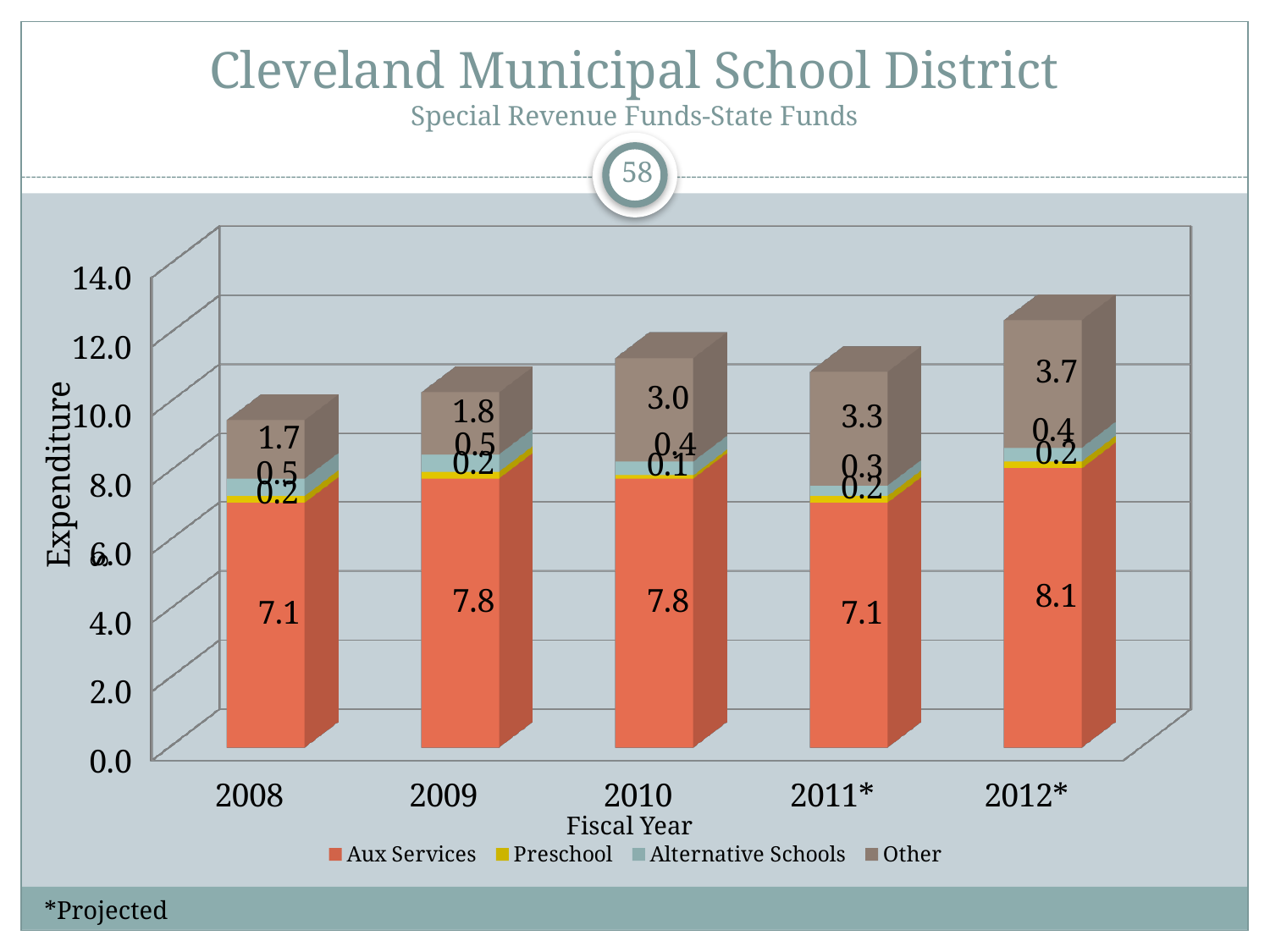
What is the Other value for fiscal year 2010? 3.0 How many series does the legend list? 4 What is the Aux Services value for 2012*? 8.1 What is the total of the stacked bar for 2012*? 12.4 Which fiscal year has the highest Other value? 2012* Does the Other value rise or fall from 2008 to 2012*? Rises How many fiscal years are shown on the x axis? 5 What is the Alternative Schools value for 2008? 0.5 What kind of chart is shown on the slide? Stacked bar chart What is the difference between the Other value in 2012* and in 2008? 2.0 Which fiscal year has the highest Aux Services value? 2012* Which is larger, the Aux Services value for 2009 or for 2011*? 2009